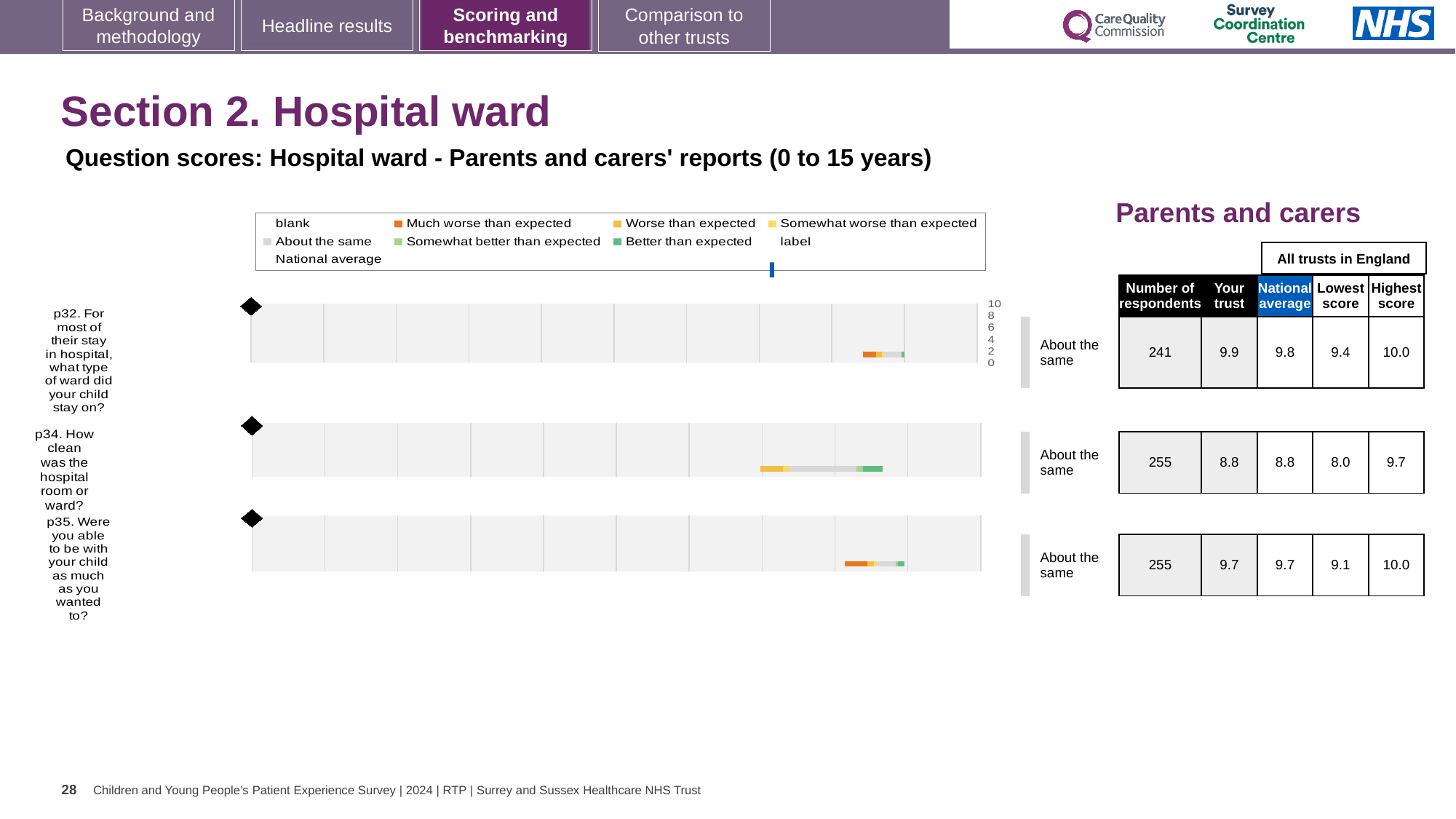
Which legend entry is shown in orange? Much worse than expected For p32, which is larger: the 'Your trust' score or the national average? Your trust For p34, what is the difference between the highest score and the lowest score among all trusts in England? 1.7 What is the 'Your trust' score for p34 (How clean was the hospital room or ward?)? 8.8 Which question has the highest 'Your trust' score? p32 What kind of chart is used to show the question scores for the hospital ward questions? bar chart What is the lowest score among all trusts in England for p35? 9.1 How many questions (p32, p34, p35) are plotted on the slide? 3 What benchmark category is shown for p34 (How clean was the hospital room or ward?)? About the same What is the national average score for p35 (Were you able to be with your child as much as you wanted to?)? 9.7 How many respondents answered p32 (what type of ward did your child stay on)? 241 Which question has the lowest 'Your trust' score? p34